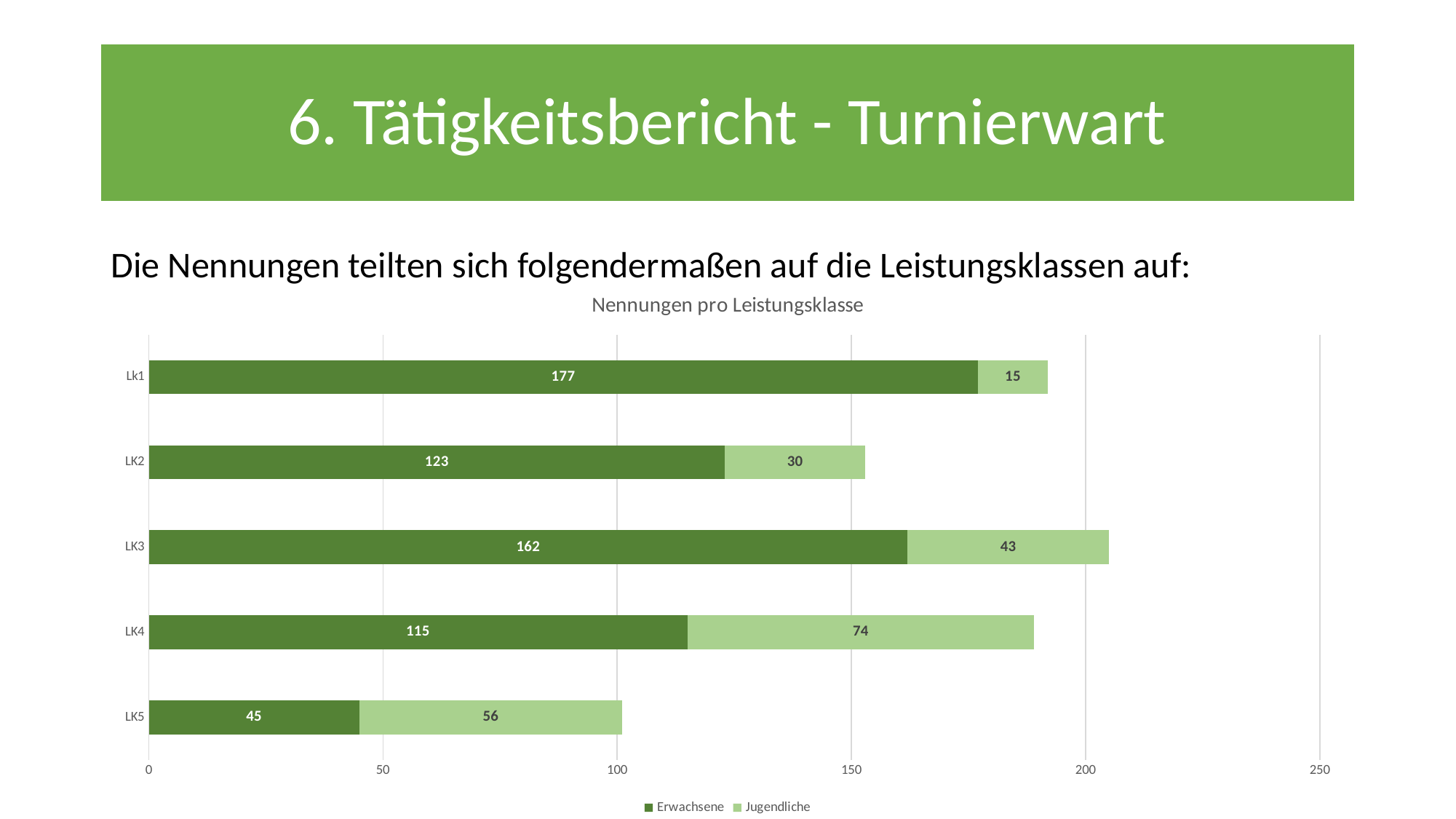
Which Leistungsklasse has the highest Erwachsene value? Lk1 What is the difference between the Erwachsene values for LK3 and LK2? 39 How many series does the legend list? 2 What is the Erwachsene value for Lk1? 177 What is the Jugendliche value for LK4? 74 What is the total of the stacked bar for LK3? 205 What kind of chart is shown? Stacked bar chart How many Leistungsklassen are shown on the chart? 5 Which is larger, the Jugendliche value for LK5 or for LK3? LK5 What is the total of the stacked bar for LK4? 189 What is the Erwachsene value for LK5? 45 Which Leistungsklasse has the lowest Jugendliche value? Lk1